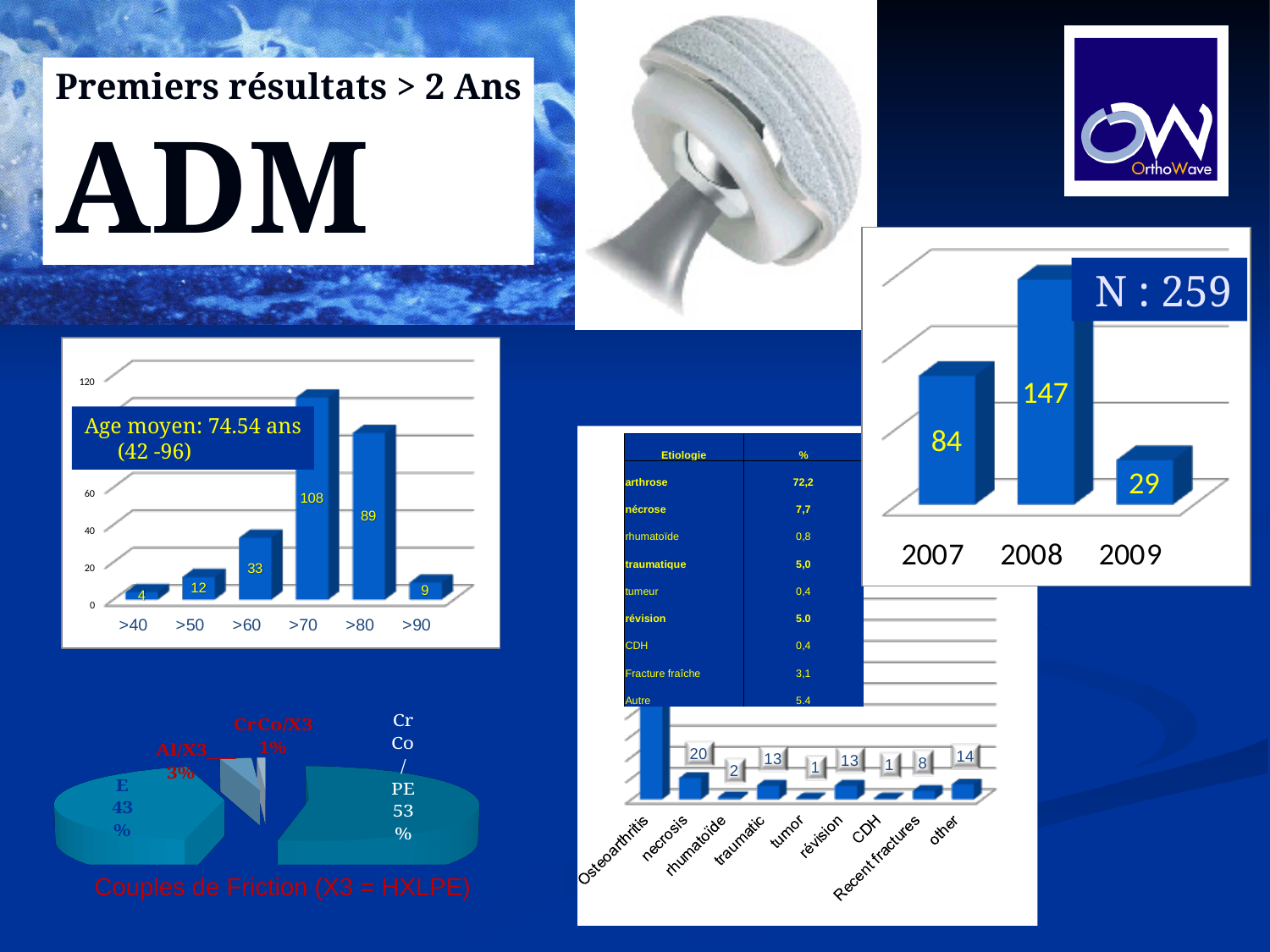
How many age categories are shown in the age distribution bar chart on the left? 6 In the age distribution bar chart on the left, which age category has the lowest value? >40 What kind of chart is the chart by year on the right (N : 259)? bar chart In the etiology bar chart at the bottom right, what is the value for necrosis? 20 In the age distribution bar chart on the left, which age category has the highest value? >70 In the age distribution bar chart on the left, what is the value for the >70 category? 108 In the age distribution bar chart on the left, what is the difference between the values for >70 and >80? 19 In the bar chart by year on the right (N : 259), what is the value for 2008? 147 In the bar chart by year on the right (N : 259), which year has the lowest value? 2009 In the bar chart by year on the right (N : 259), what is the difference between the values for 2008 and 2007? 63 In the pie chart at the bottom left (Couples de Friction), what share does CrCo/PE have? 53% In the etiology bar chart at the bottom right, which is larger, the value for necrosis or the value for other? necrosis